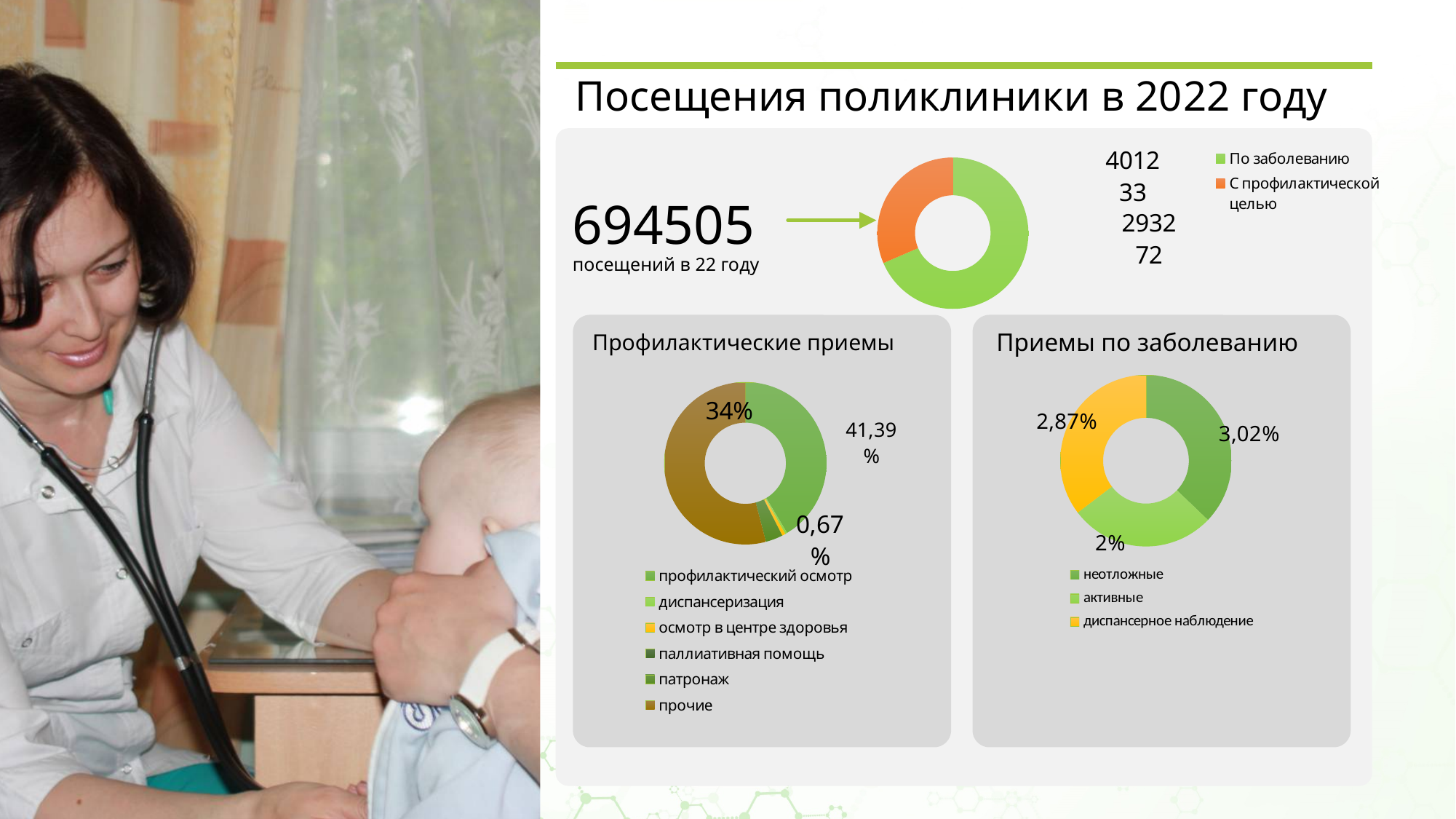
In the 'Приемы по заболеванию' chart, which category has the lowest value? активные How many categories does the legend of the 'Приемы по заболеванию' chart list? 3 In the 'Приемы по заболеванию' chart, which is larger: неотложные or диспансерное наблюдение? неотложные In the 'Приемы по заболеванию' chart, which category has the highest value? неотложные How many categories does the legend of the 'Профилактические приемы' chart list? 6 In the 'Приемы по заболеванию' chart, what is the difference between неотложные and активные? 1,02% In the 'Приемы по заболеванию' chart, what is the value for неотложные? 3,02% In the 'Приемы по заболеванию' chart, what is the value for диспансерное наблюдение? 2,87% In the 'Приемы по заболеванию' chart, what is the value for активные? 2% In the top doughnut chart next to '694505', how many series does the legend list? 2 What type of chart is used in the 'Приемы по заболеванию' panel? Doughnut (pie) chart In the top doughnut chart next to '694505', which slice is larger: 'По заболеванию' or 'С профилактической целью'? По заболеванию